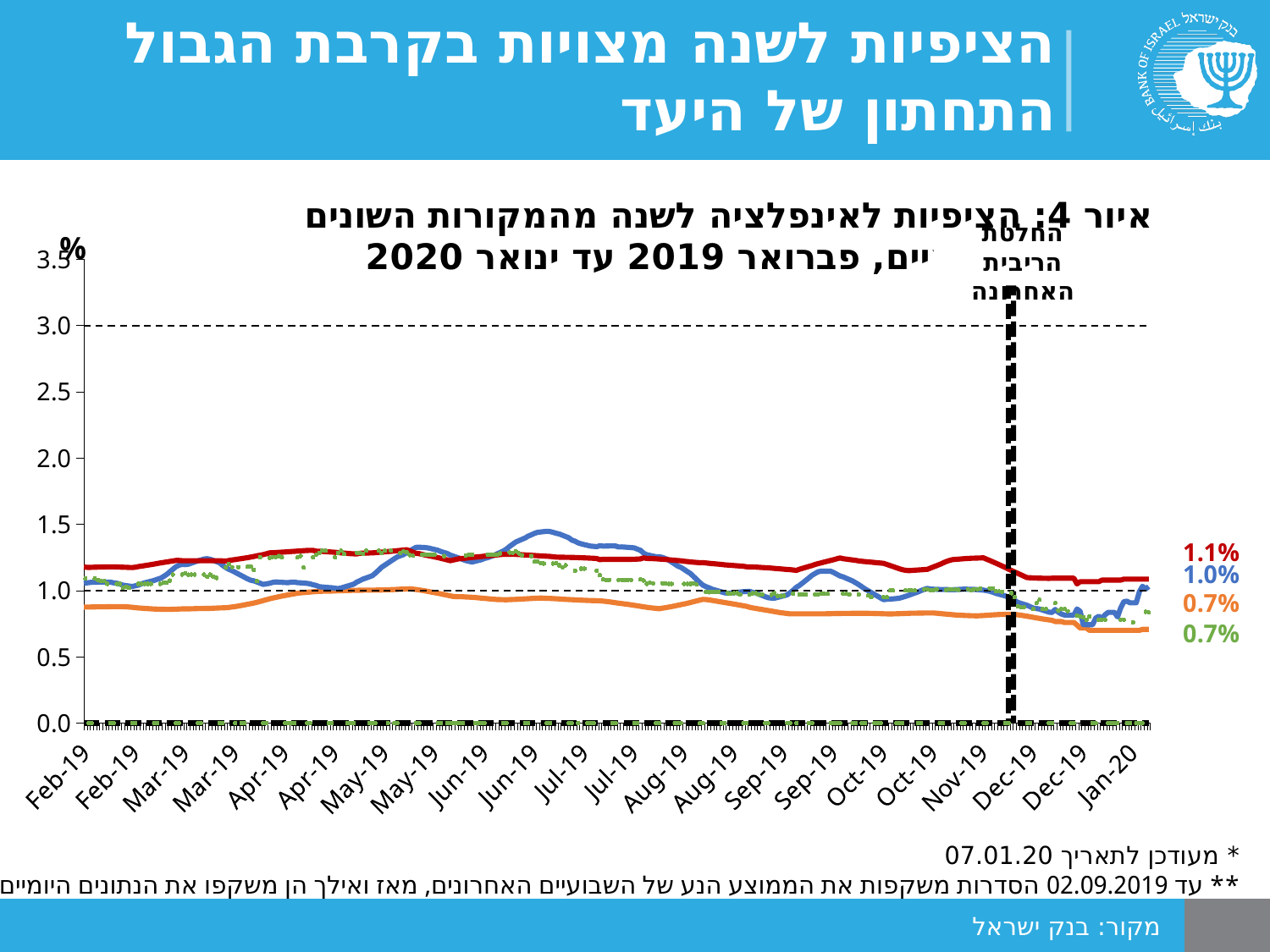
Is the value of the blue line in Jun-19 greater or less than 1.0? greater What is the final value labelled for the orange line at the right edge of the chart? 0.7% What kind of chart is shown on the slide? line chart What is the difference between the final labelled values of the red line and the orange line? 0.4% What is the final value labelled for the green dotted line at the right edge of the chart? 0.7% Does the orange line generally rise or fall from Apr-19 to Jan-20? fall How many lines (series) are plotted on the chart? 4 What is the final value labelled for the blue line at the right edge of the chart? 1.0% What is the highest value shown on the vertical axis of the chart? 3.5 What is the final value labelled for the red line at the right edge of the chart? 1.1% Which line has the highest labelled value at the end of the chart? the red line (1.1%) Which is larger at the end of the chart, the red line's value or the blue line's value? the red line (1.1%)